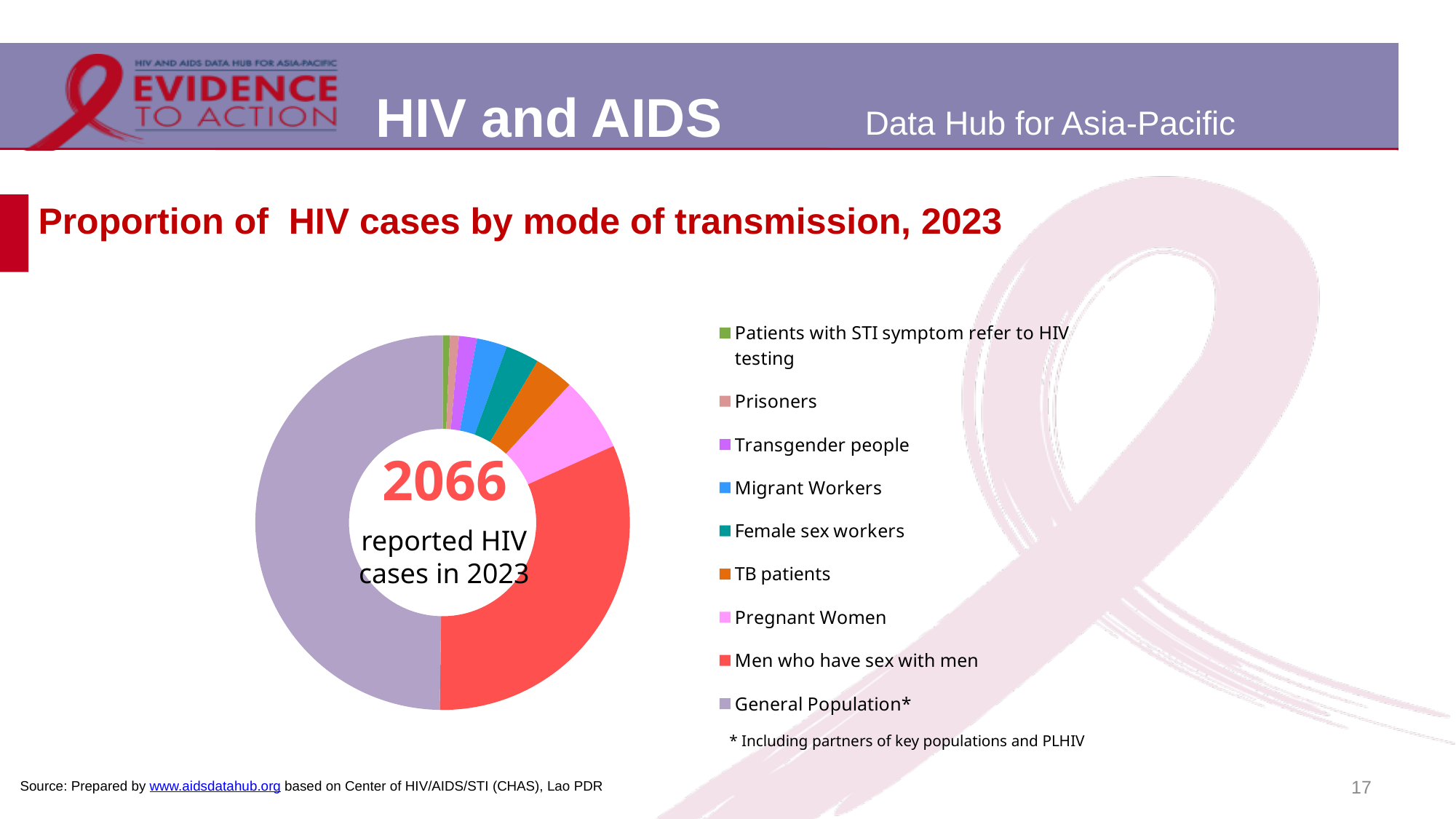
Which category has the smallest share of the pie? Patients with STI symptom refer to HIV testing What colour represents Men who have sex with men in the chart? Red Which has a larger share of the pie: Men who have sex with men or Pregnant Women? Men who have sex with men What is the title of the chart on the slide? Proportion of HIV cases by mode of transmission, 2023 Which has a larger share of the pie: Pregnant Women or TB patients? Pregnant Women What kind of chart is shown on the slide? Pie (donut) chart Which has a larger share of the pie: General Population* or Men who have sex with men? General Population* Which category has the largest share of the pie? General Population* What total number of reported HIV cases in 2023 is shown in the centre of the chart? 2066 How many categories does the chart's legend list? 9